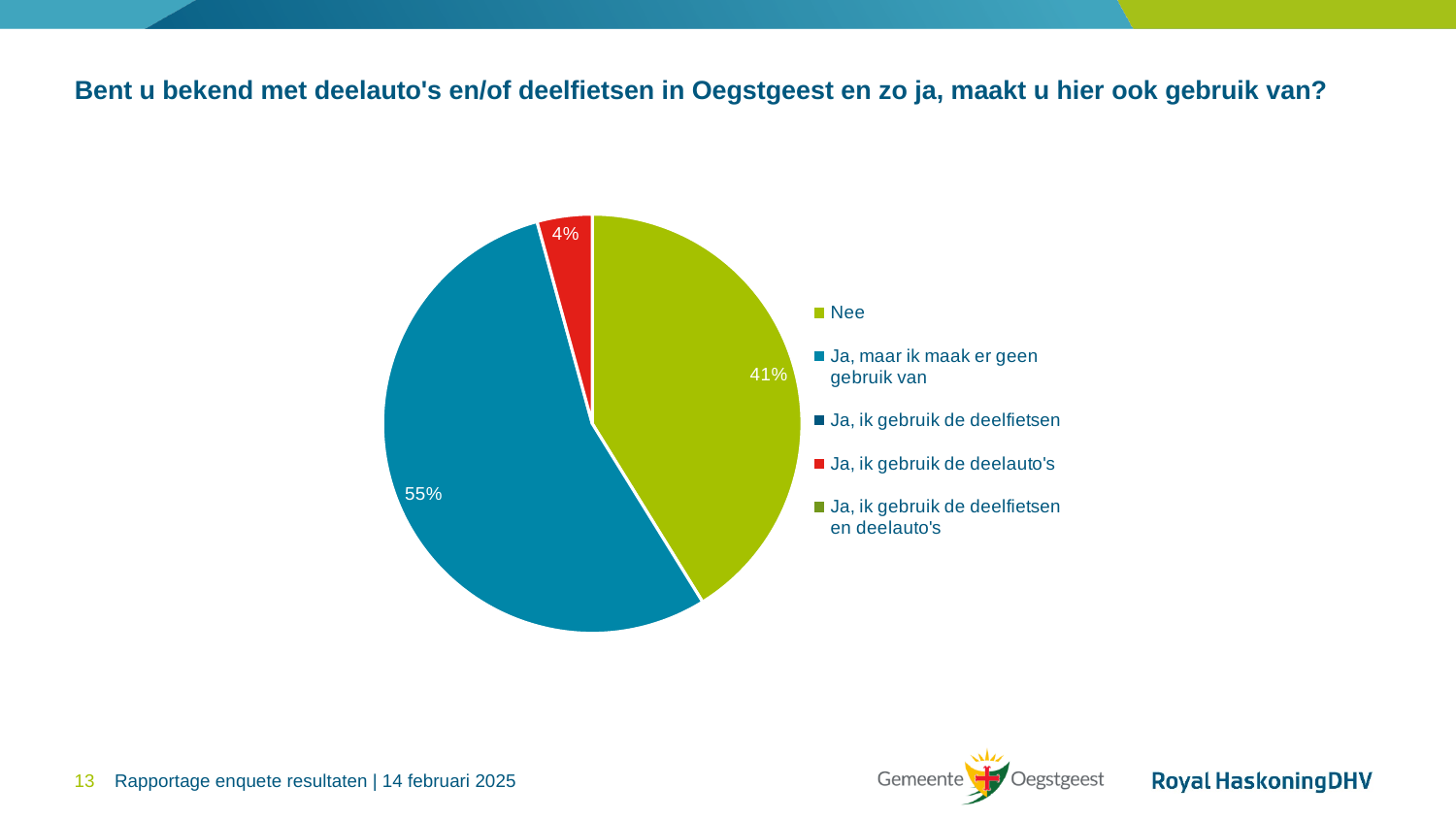
Which answer category has the largest share of the pie? Ja, maar ik maak er geen gebruik van What type of chart is shown on the slide? Pie chart What percentage of respondents answered "Nee"? 41% How many percentage points larger is the share for "Ja, maar ik maak er geen gebruik van" than the share for "Nee"? 14 percentage points Which is larger: the share for "Nee" or the share for "Ja, ik gebruik de deelauto's"? Nee How many answer categories are listed in the legend? 5 What percentage of respondents answered "Ja, ik gebruik de deelauto's"? 4% What question is shown as the title of the slide? Bent u bekend met deelauto's en/of deelfietsen in Oegstgeest en zo ja, maakt u hier ook gebruik van? Which of the labelled slices has the smallest share of the pie? Ja, ik gebruik de deelauto's What percentage of respondents answered "Ja, maar ik maak er geen gebruik van"? 55% What colour is the slice for "Nee"? Green How many slices of the pie have a percentage label? 3